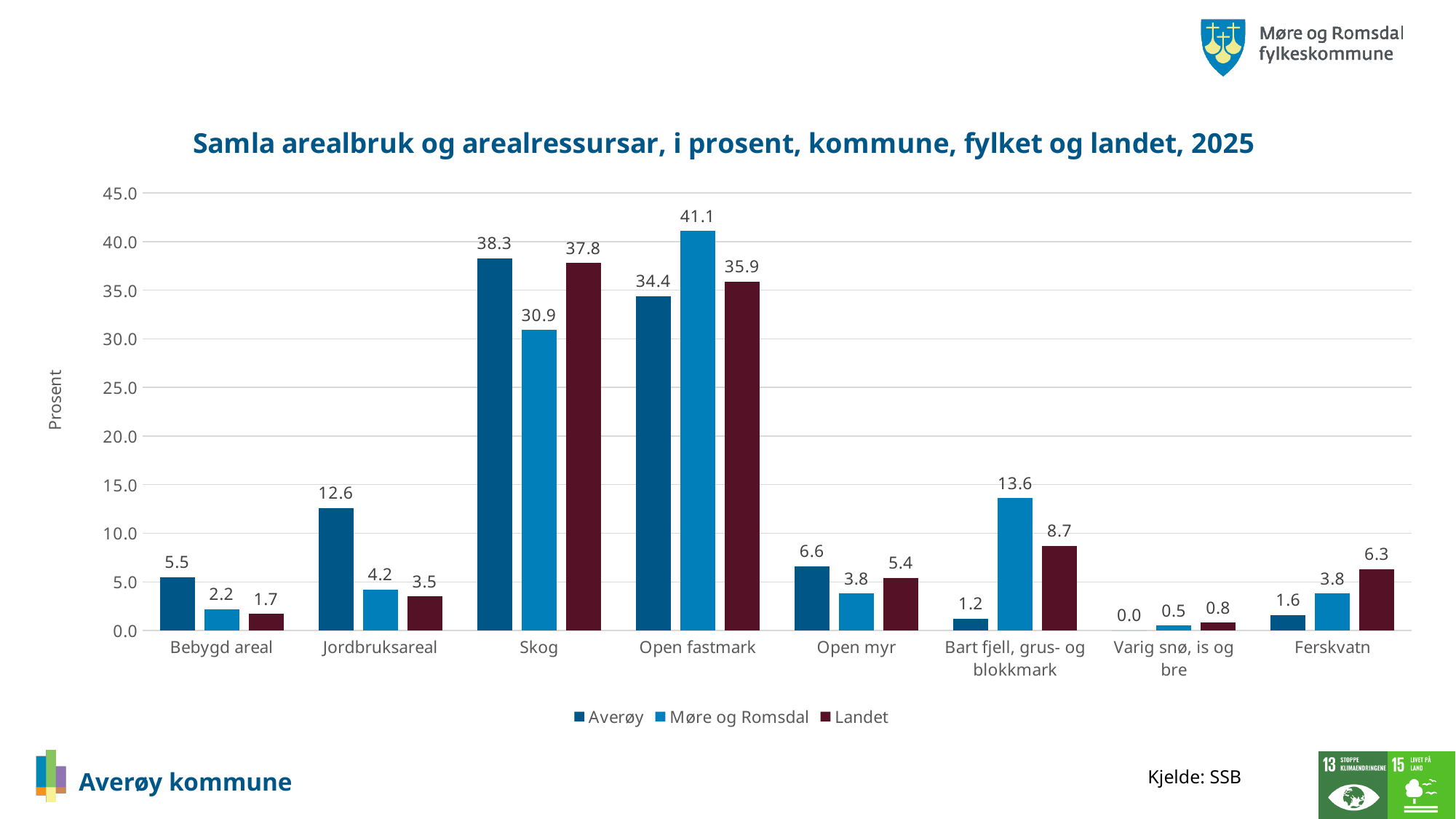
What kind of chart is shown on the slide? Bar chart Which category has the lowest value for Møre og Romsdal? Varig snø, is og bre What is the value for Møre og Romsdal in the Open fastmark category? 41.1 What is the value for Averøy in the Skog category? 38.3 What is the label of the y axis? Prosent In the Open myr category, which is larger: the value for Averøy or the value for Landet? Averøy What is the difference between the Averøy and Møre og Romsdal values for Jordbruksareal? 8.4 Is the value for Landet in the Skog category greater or less than 35.0? greater What is the value for Landet in the Bart fjell, grus- og blokkmark category? 8.7 Which category has the highest value for Averøy? Skog How many categories are shown on the x axis? 8 How many series does the legend list? 3